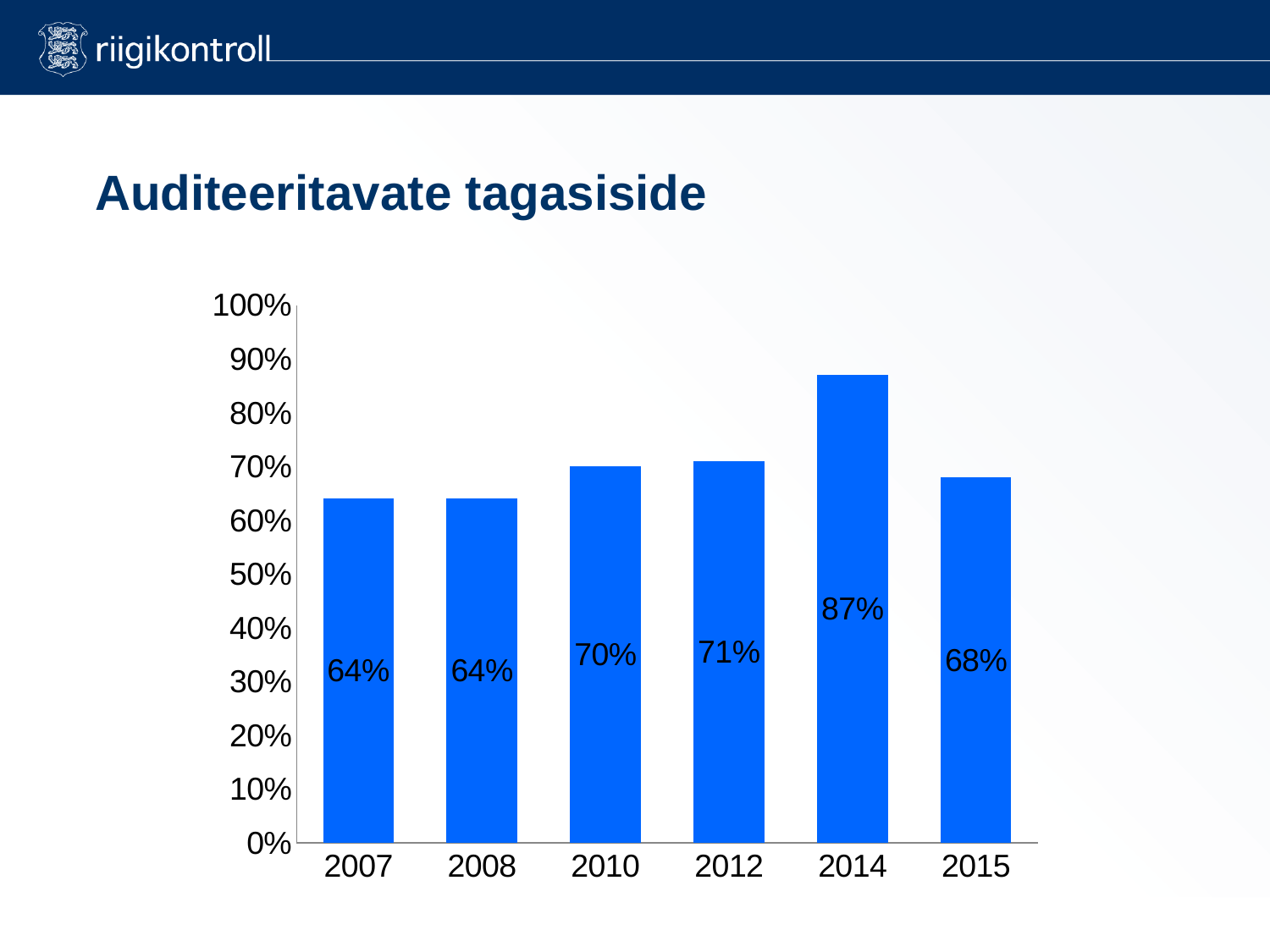
Is the value for 2008 greater or less than 70%? less What is the difference between the values for 2012 and 2007? 7% How many years are shown on the x axis? 6 What kind of chart is shown on the slide? bar chart What is the value for 2015? 68% What is the difference between the values for 2014 and 2015? 19% What is the value for 2010? 70% What is the title of the slide? Auditeeritavate tagasiside Is the value for 2014 greater or less than 80%? greater What is the value for 2014? 87% Which is larger, the value for 2012 or the value for 2015? 2012 Which year has the highest value? 2014